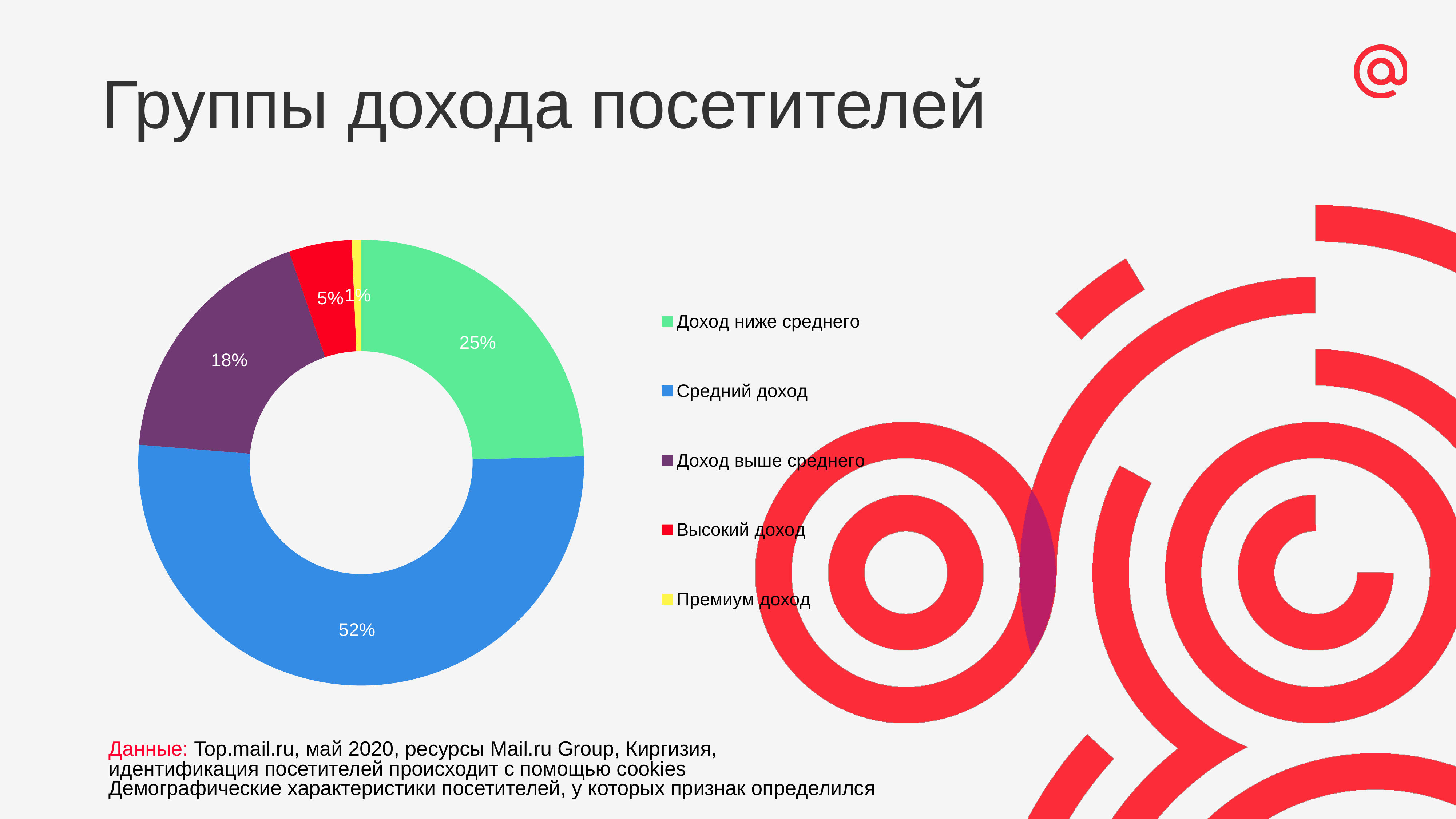
What share of visitors falls into the "Высокий доход" group? 5% What share of visitors falls into the "Доход выше среднего" group? 18% What is the difference in percentage points between the "Средний доход" and "Доход ниже среднего" shares? 27 Which is larger: the share for "Доход выше среднего" or the share for "Высокий доход"? Доход выше среднего What share of visitors falls into the "Средний доход" group? 52% How many income groups are shown in the chart? 5 What colour represents the "Высокий доход" group in the chart? Red What share of visitors falls into the "Доход ниже среднего" group? 25% What type of chart is used on this slide? Doughnut (pie) chart Which income group has the smallest share of visitors? Премиум доход What share of visitors falls into the "Премиум доход" group? 1% Which income group has the largest share of visitors? Средний доход